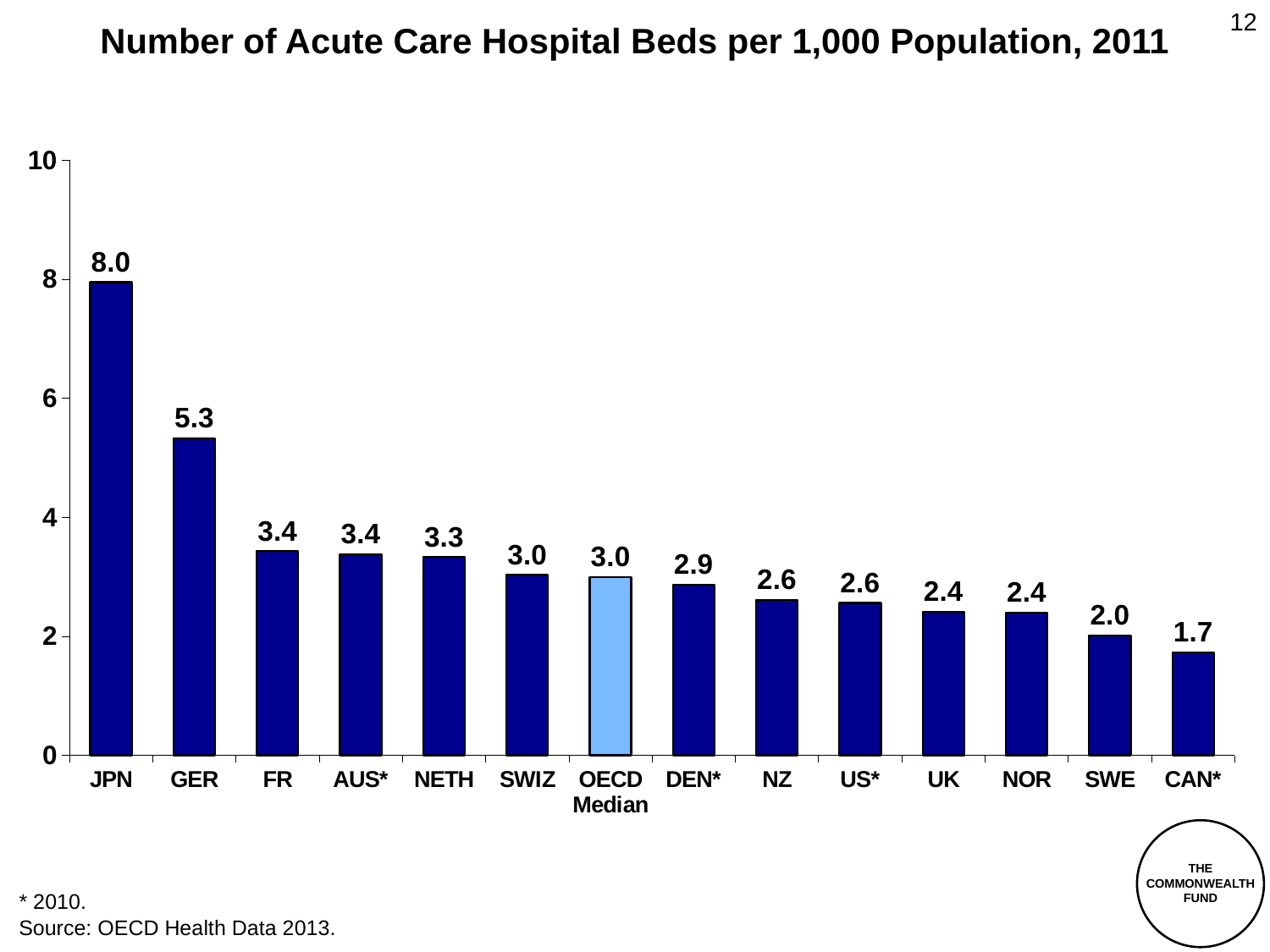
Which country has the lowest number of acute care hospital beds per 1,000 population? CAN* How many bars are shown in the chart? 14 Which country has the highest number of acute care hospital beds per 1,000 population? JPN Which has a higher value, GER or FR? GER What is the difference between the values for JPN and GER? 2.7 What is the number of acute care hospital beds per 1,000 population for Japan (JPN)? 8.0 Is the value for NETH greater or less than 4? less What is the difference between the values for the UK and CAN*? 0.7 Which bar is shown in a lighter blue colour than the others? OECD Median What is the value shown for the OECD Median? 3.0 What is the value shown for the US*? 2.6 What kind of chart is shown on the slide? Bar chart